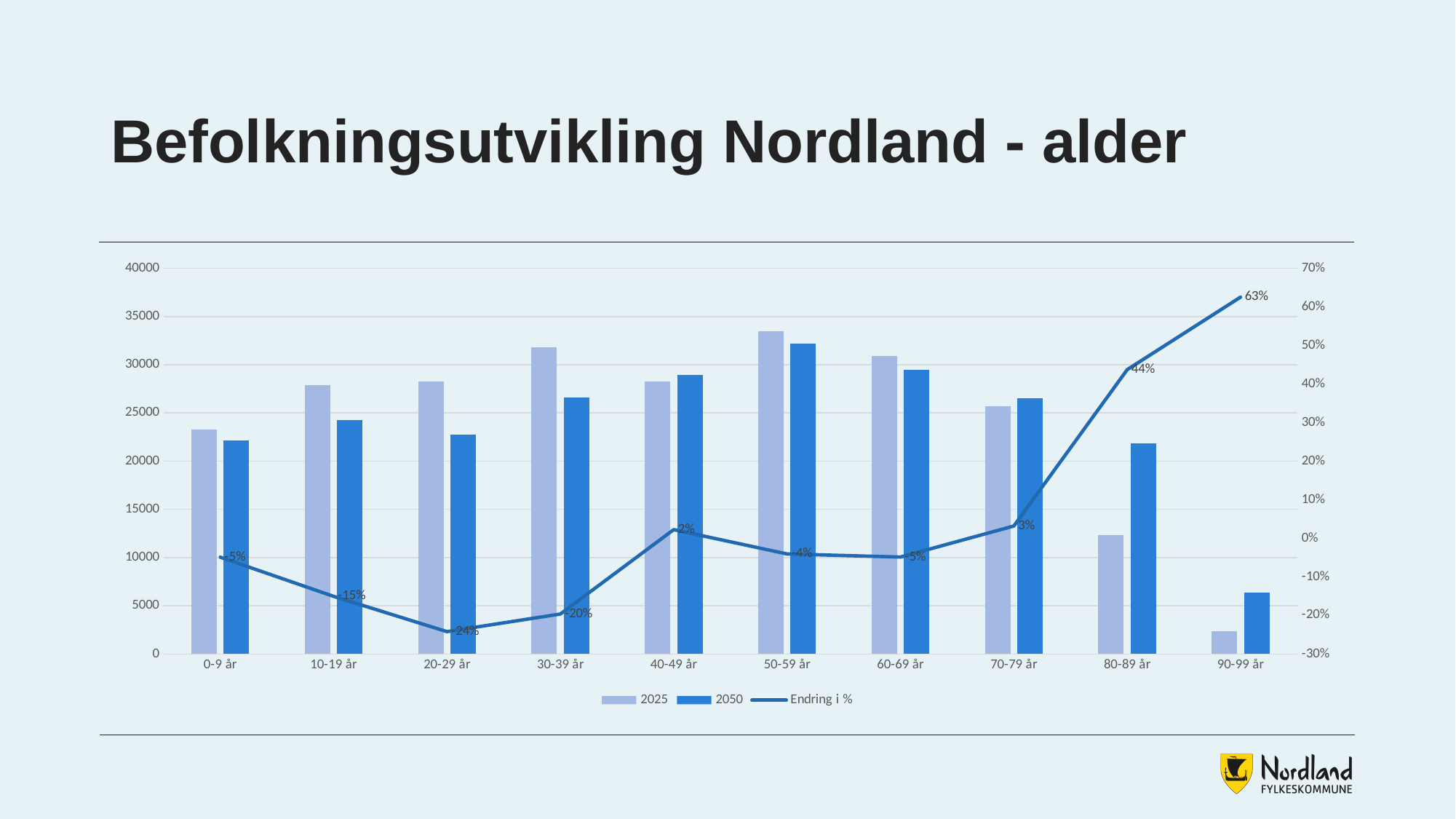
Which age group has the highest value for "Endring i %"? 90-99 år How many age groups are shown on the x axis? 10 What is the difference in "Endring i %" between the 90-99 år and 80-89 år age groups? 19 percentage points Which age group has the lowest value for "Endring i %"? 20-29 år Is the 2050 value for the 90-99 år age group greater or less than 10000? less How many series does the legend list? 3 Is the 2025 value for the 50-59 år age group greater or less than 30000? greater Does the "Endring i %" line rise or fall from 70-79 år to 90-99 år? rise For the 80-89 år age group, which is larger: the 2025 value or the 2050 value? 2050 What is the value of "Endring i %" for the 80-89 år age group? 44% What is the value of "Endring i %" for the 90-99 år age group? 63% What is the value of "Endring i %" for the 20-29 år age group? -24%